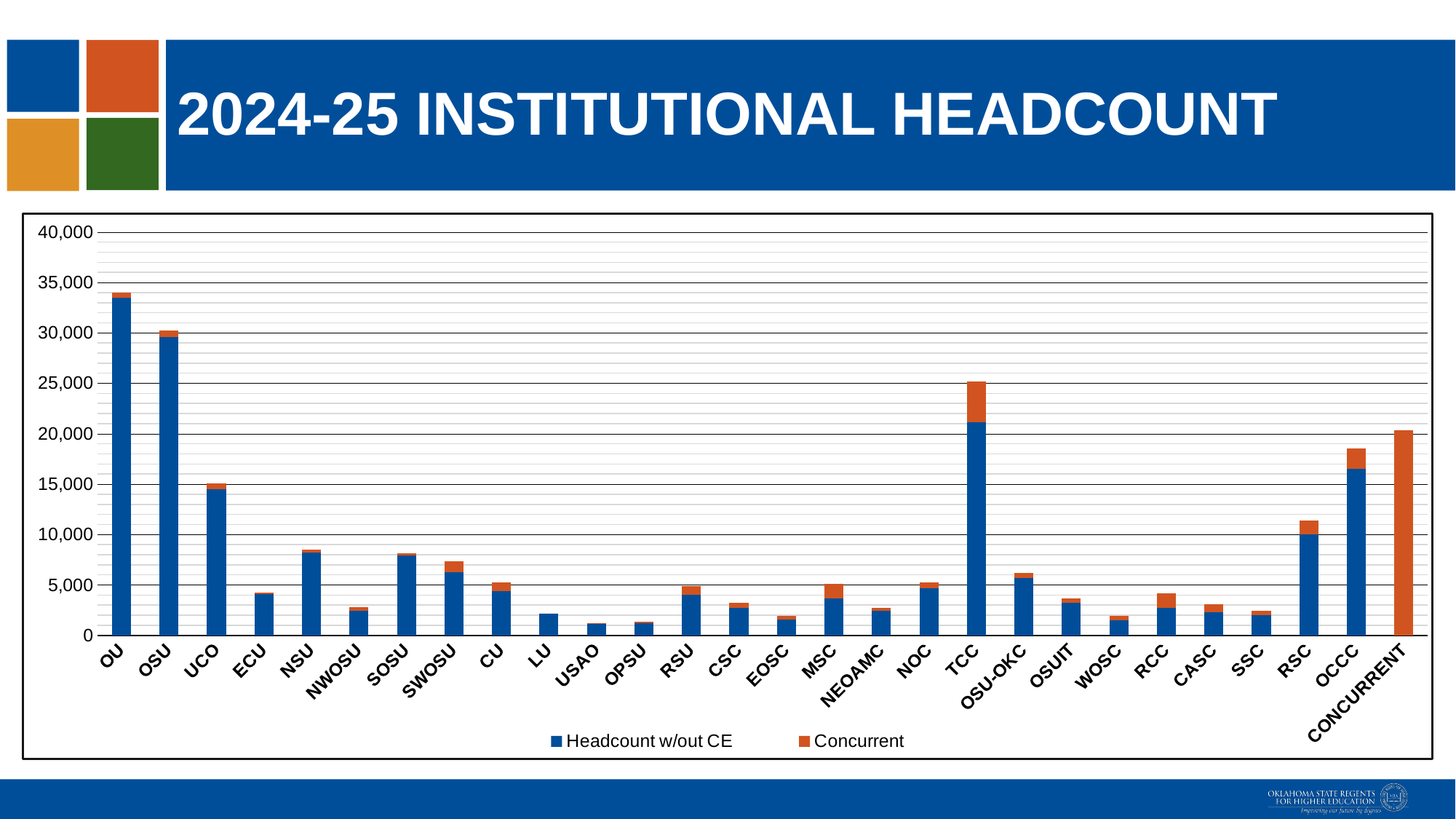
Which has the larger total headcount, UCO or NSU? UCO Which category has the highest total headcount? OU Which has the larger total headcount, TCC or OCCC? TCC Is the total bar for TCC greater or less than 20,000? greater What kind of chart is shown on the slide? Stacked bar chart Is the total bar for OCCC greater or less than 15,000? greater Is the total bar for OU greater or less than 30,000? greater How many categories are shown along the x axis? 28 What is the title of the slide? 2024-25 INSTITUTIONAL HEADCOUNT What are the two series named in the legend? Headcount w/out CE and Concurrent How many series does the legend list? 2